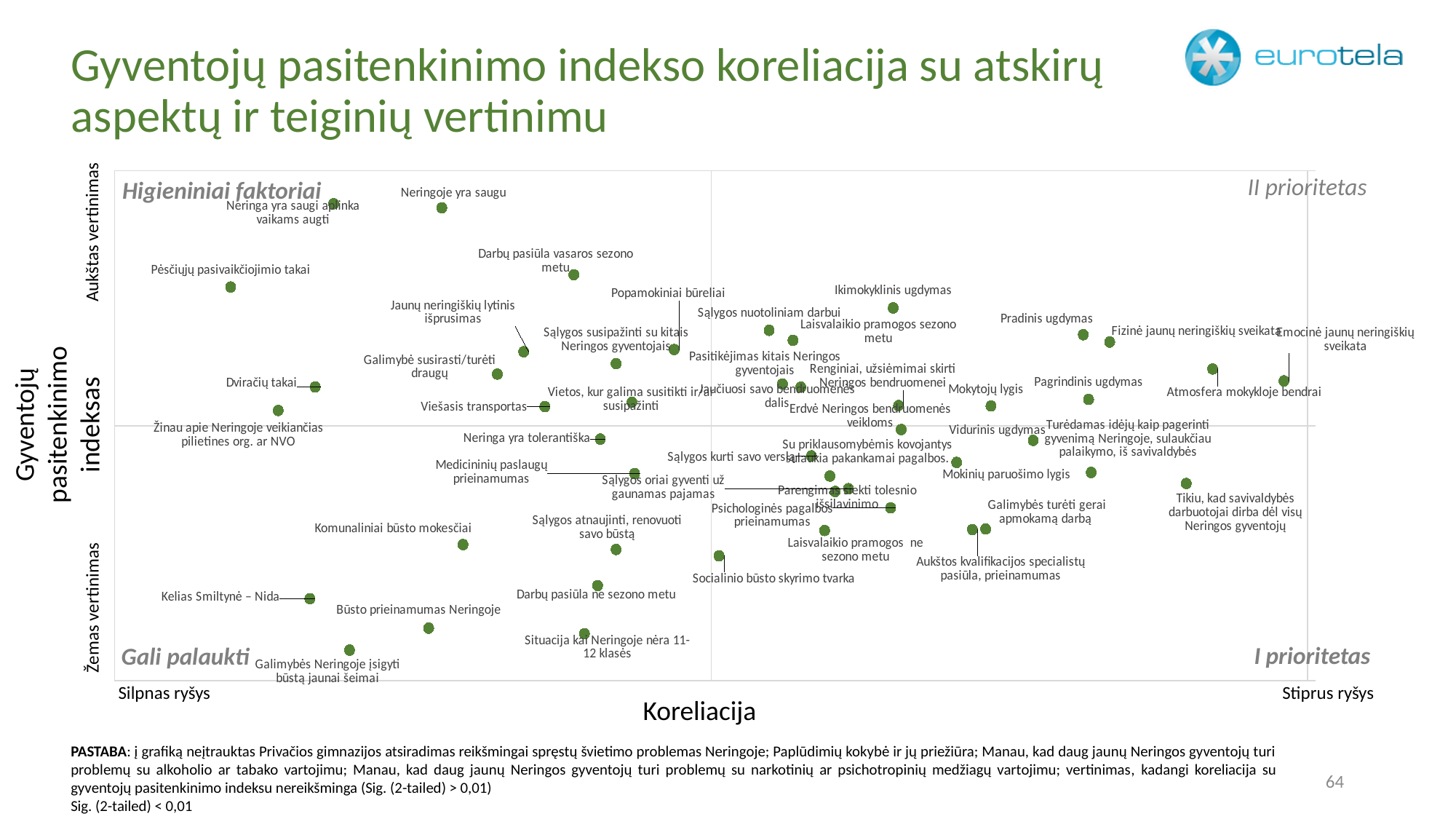
In which quadrant of the chart is "Aukštos kvalifikacijos specialistų pasiūla, prieinamumas" located? I prioritetas Which point is plotted furthest to the right (strongest correlation)? Emocinė jaunų neringiškių sveikata What is the label of the horizontal axis of the chart? Koreliacija Which point is plotted furthest to the left (weakest correlation)? Pėsčiųjų pasivaikščiojimo takai What is the label of the vertical axis of the chart? Gyventojų pasitenkinimo indeksas What kind of chart is shown on the slide? scatter chart In which quadrant of the chart is "Pėsčiųjų pasivaikščiojimo takai" located? Higieniniai faktoriai Which point is plotted lowest on the vertical axis (lowest satisfaction index)? Galimybės Neringoje įsigyti būstą jaunai šeimai Which has a higher satisfaction index: "Neringoje yra saugu" or "Kelias Smiltynė – Nida"? Neringoje yra saugu In which quadrant of the chart is "Pradinis ugdymas" located? II prioritetas Which has a stronger correlation: "Pradinis ugdymas" or "Dviračių takai"? Pradinis ugdymas In which quadrant of the chart is "Komunaliniai būsto mokesčiai" located? Gali palaukti